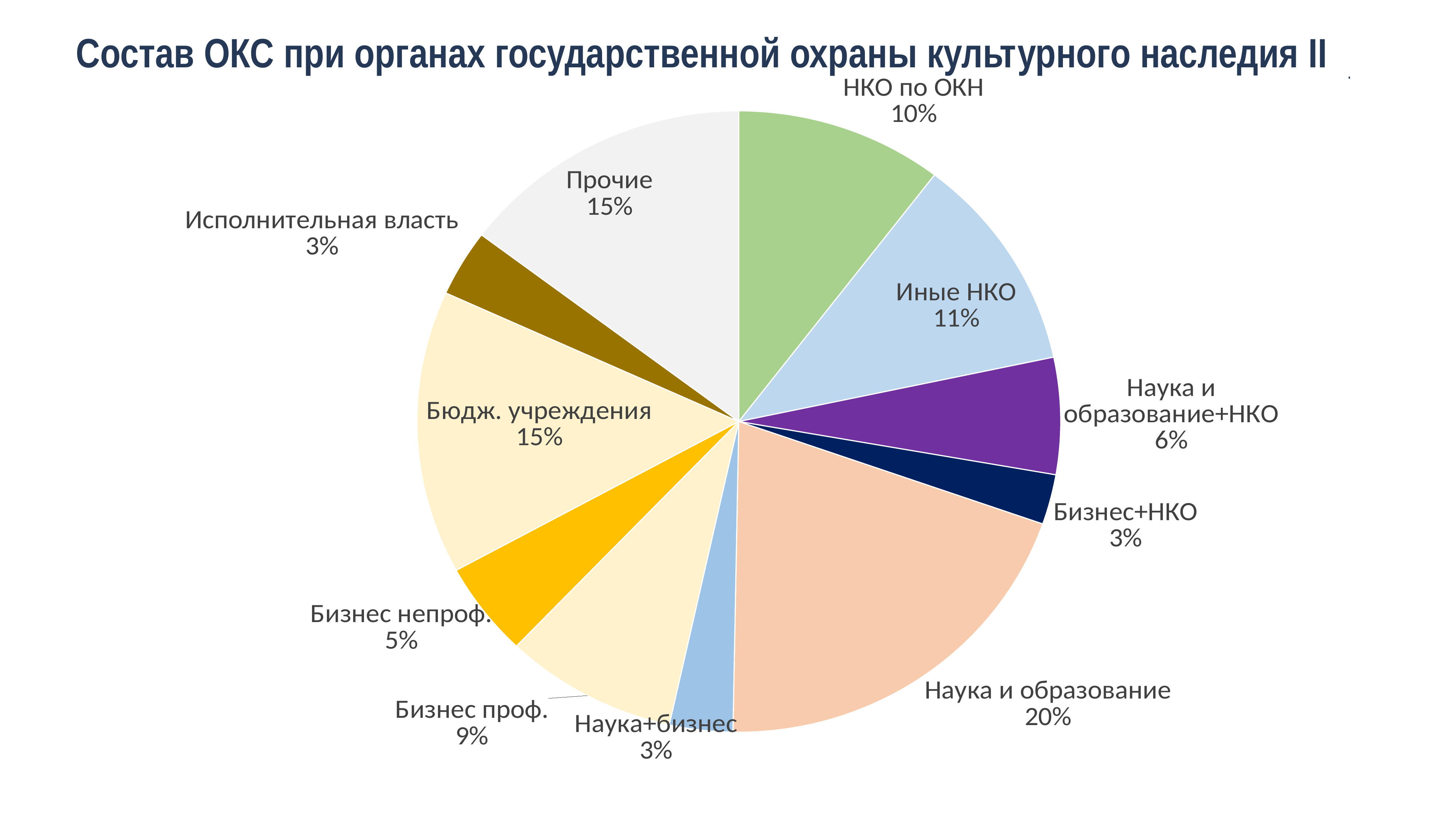
What is the difference in percentage points between Наука и образование and НКО по ОКН? 10 How many categories are shown in the pie chart? 11 What kind of chart is shown on the slide? Pie chart Which is larger, Прочие or Иные НКО? Прочие Which category has the largest slice of the pie? Наука и образование What share is labelled for Наука и образование+НКО? 6% What is the value for Бизнес проф.? 9% What is the difference in percentage points between Бюдж. учреждения and Бизнес непроф.? 10 What is the title of the chart? Состав ОКС при органах государственной охраны культурного наследия II Which is larger, Бизнес проф. or Бизнес непроф.? Бизнес проф. What percentage is shown for Бюдж. учреждения? 15% What share of the pie does Наука и образование have? 20%